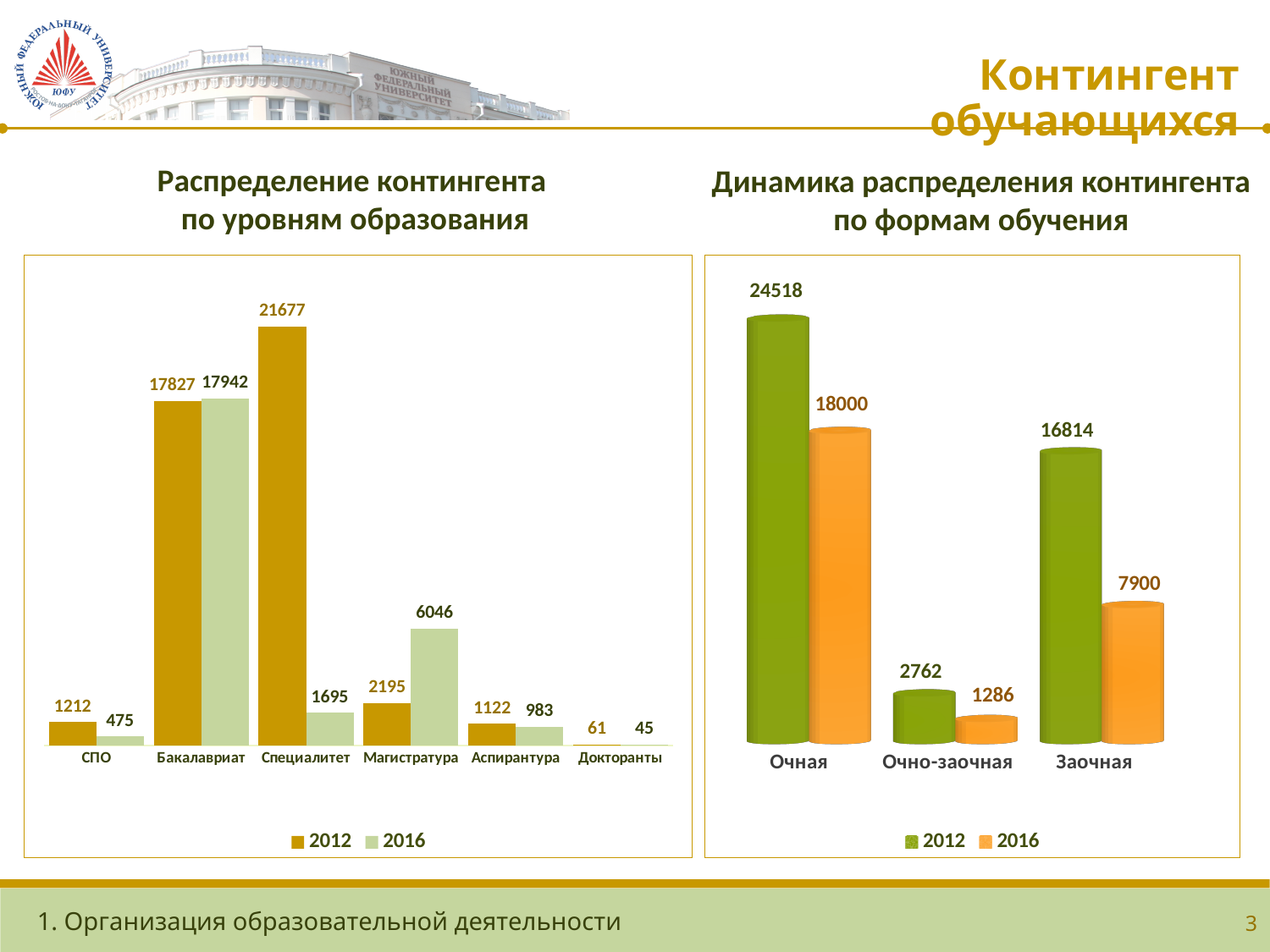
In the chart 'Распределение контингента по уровням образования', what is the value for Магистратура in 2016? 6046 In the chart 'Динамика распределения контингента по формам обучения', how many series does the legend list? 2 In the chart 'Распределение контингента по уровням образования', how many categories are shown on the x axis? 6 In the chart 'Распределение контингента по уровням образования', what is the value for Специалитет in 2012? 21677 In the chart 'Динамика распределения контингента по формам обучения', what is the difference between the 2012 and 2016 values for Очная? 6518 In the chart 'Распределение контингента по уровням образования', what is the difference between the 2012 and 2016 values for СПО? 737 In the chart 'Динамика распределения контингента по формам обучения', what is the value for Заочная in 2016? 7900 What type of chart is 'Динамика распределения контингента по формам обучения'? bar chart In the chart 'Распределение контингента по уровням образования', which category has the highest value in 2012? Специалитет In the chart 'Распределение контингента по уровням образования', is the 2016 value for Бакалавриат larger or smaller than the 2012 value? larger In the chart 'Распределение контингента по уровням образования', which category has the lowest value in 2016? Докторанты In the chart 'Динамика распределения контингента по формам обучения', which category has the lowest value in 2012? Очно-заочная